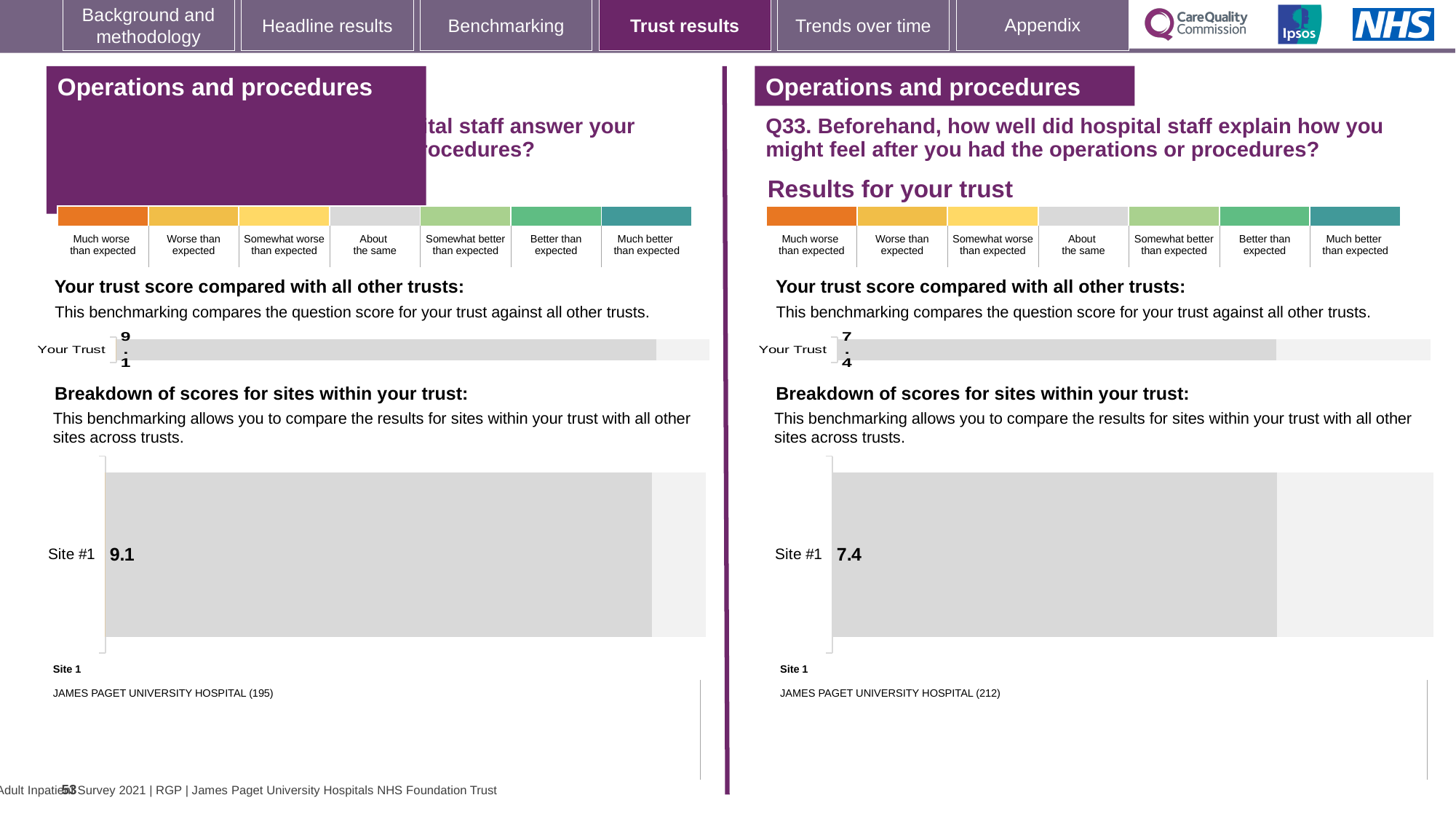
On the right half of the slide (Q33), in the 'Breakdown of scores for sites within your trust' chart, what is the value for Site #1? 7.4 On the left half of the slide, which site name is listed as Site 1 below the breakdown chart? JAMES PAGET UNIVERSITY HOSPITAL (195) On the left half of the slide, in the 'Your trust score compared with all other trusts' chart, what is the value for Your Trust? 9.1 What kind of chart is used for the 'Breakdown of scores for sites within your trust' section on the left half of the slide? Bar chart On the right half of the slide (Q33), in the 'Your trust score compared with all other trusts' chart, what is the value for Your Trust? 7.4 How many sites are shown in the 'Breakdown of scores for sites within your trust' chart on the left half of the slide? 1 What kind of chart is used for the 'Your trust score compared with all other trusts' section on the right half of the slide (Q33)? Bar chart On the right half of the slide (Q33), which site name is listed as Site 1 below the breakdown chart? JAMES PAGET UNIVERSITY HOSPITAL (212) What is the difference between the Your Trust score on the left half of the slide and the Your Trust score on the right half (Q33)? 1.7 Which is larger: the Site #1 score on the left half of the slide or the Site #1 score on the right half (Q33)? Left half (9.1) On the left half of the slide, in the 'Breakdown of scores for sites within your trust' chart, what is the value for Site #1? 9.1 How many sites are shown in the 'Breakdown of scores for sites within your trust' chart on the right half of the slide (Q33)? 1